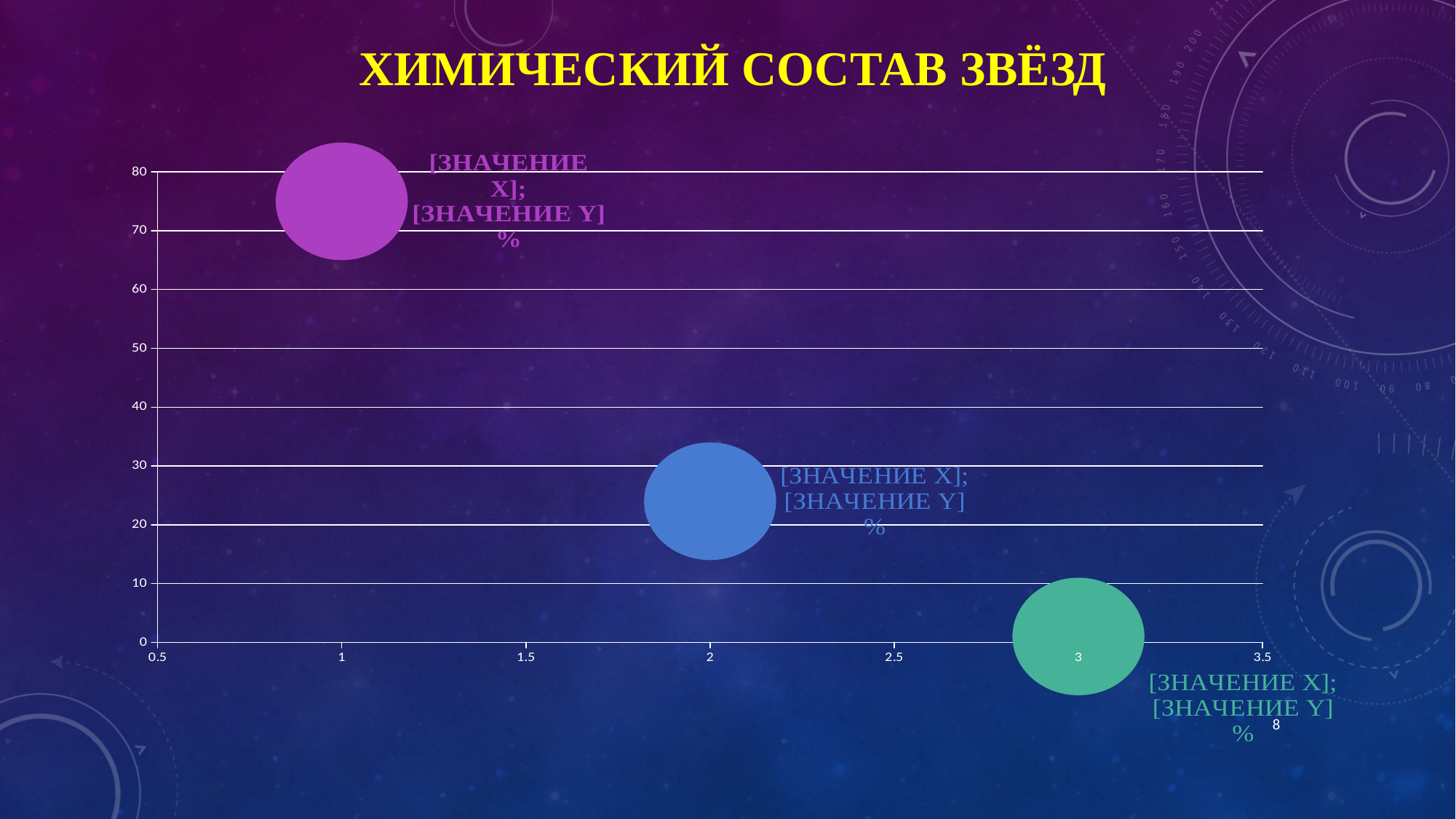
Do the y values of the bubbles rise or fall as x increases? fall Which bubble has a larger y value, the one at x = 1 or the one at x = 2? the one at x = 1 Is the y value of the bubble at x = 3 greater or less than 20? less What colour is the bubble at x = 3? green Is the y value of the bubble at x = 1 greater or less than 60? greater Which x position has the bubble with the highest y value? 1 What kind of chart is shown on the slide? bubble chart How many bubbles are plotted on the chart? 3 Which x position has the bubble with the lowest y value? 3 What is the title of the slide containing the chart? ХИМИЧЕСКИЙ СОСТАВ ЗВЁЗД Is the y value of the bubble at x = 2 greater or less than 10? greater